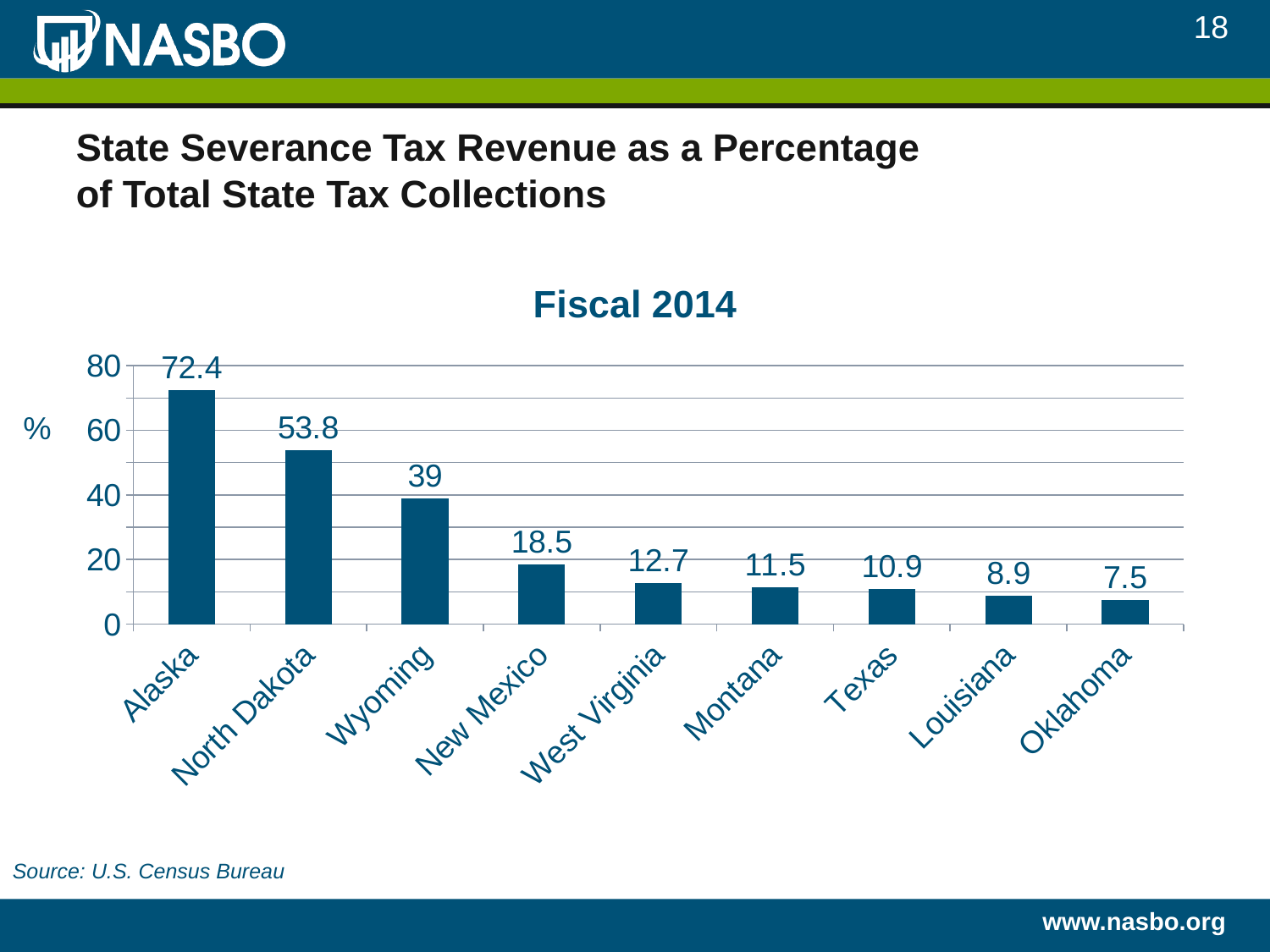
What kind of chart is shown on the slide? bar chart Which is larger, the value for Montana or the value for Texas? Montana Do the values rise or fall from left to right along the x axis? fall What is the value for Alaska? 72.4 What is the value for Louisiana? 8.9 What is the difference between the values for Wyoming and New Mexico? 20.5 What is the value for New Mexico? 18.5 Is the value for Wyoming greater or less than 40? less How many states are shown in the chart? 9 Which state has the lowest value? Oklahoma Which state has the highest value? Alaska What is the difference between the values for Alaska and North Dakota? 18.6